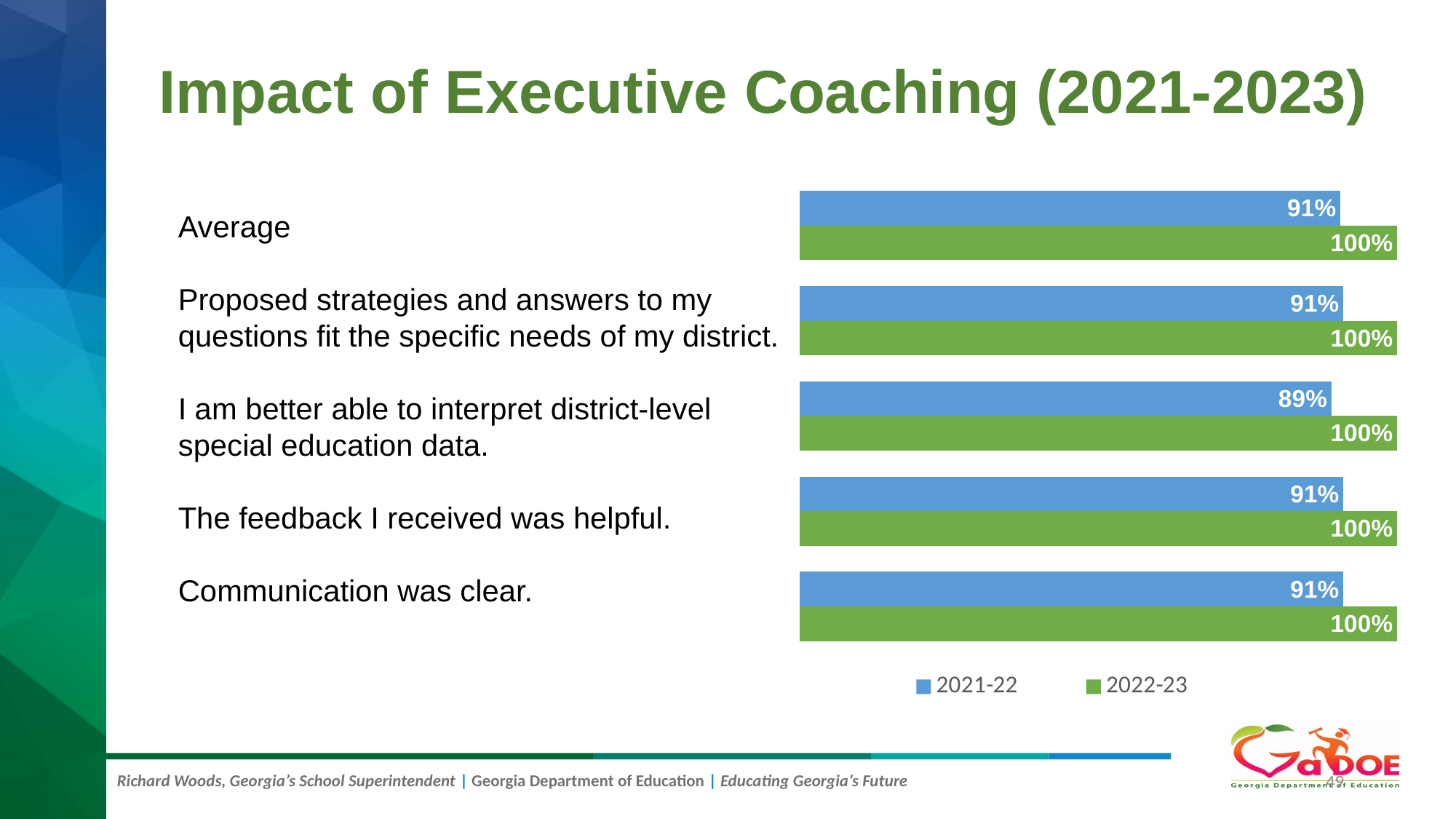
How many series does the legend list? 2 How many categories are shown in the chart? 5 What is the difference between the 2022-23 and 2021-22 values for "I am better able to interpret district-level special education data."? 11% Which colour represents the 2022-23 series in the chart? Green What is the 2022-23 value for "The feedback I received was helpful."? 100% What kind of chart is shown on the slide? Bar chart What is the difference between the 2022-23 and 2021-22 values for "Average"? 9% Which category has the lowest 2021-22 value? I am better able to interpret district-level special education data. What is the 2021-22 value for "Average"? 91% What is the 2021-22 value for "Communication was clear."? 91% Which is larger for "Communication was clear.": the 2021-22 value or the 2022-23 value? 2022-23 What is the 2021-22 value for "I am better able to interpret district-level special education data."? 89%